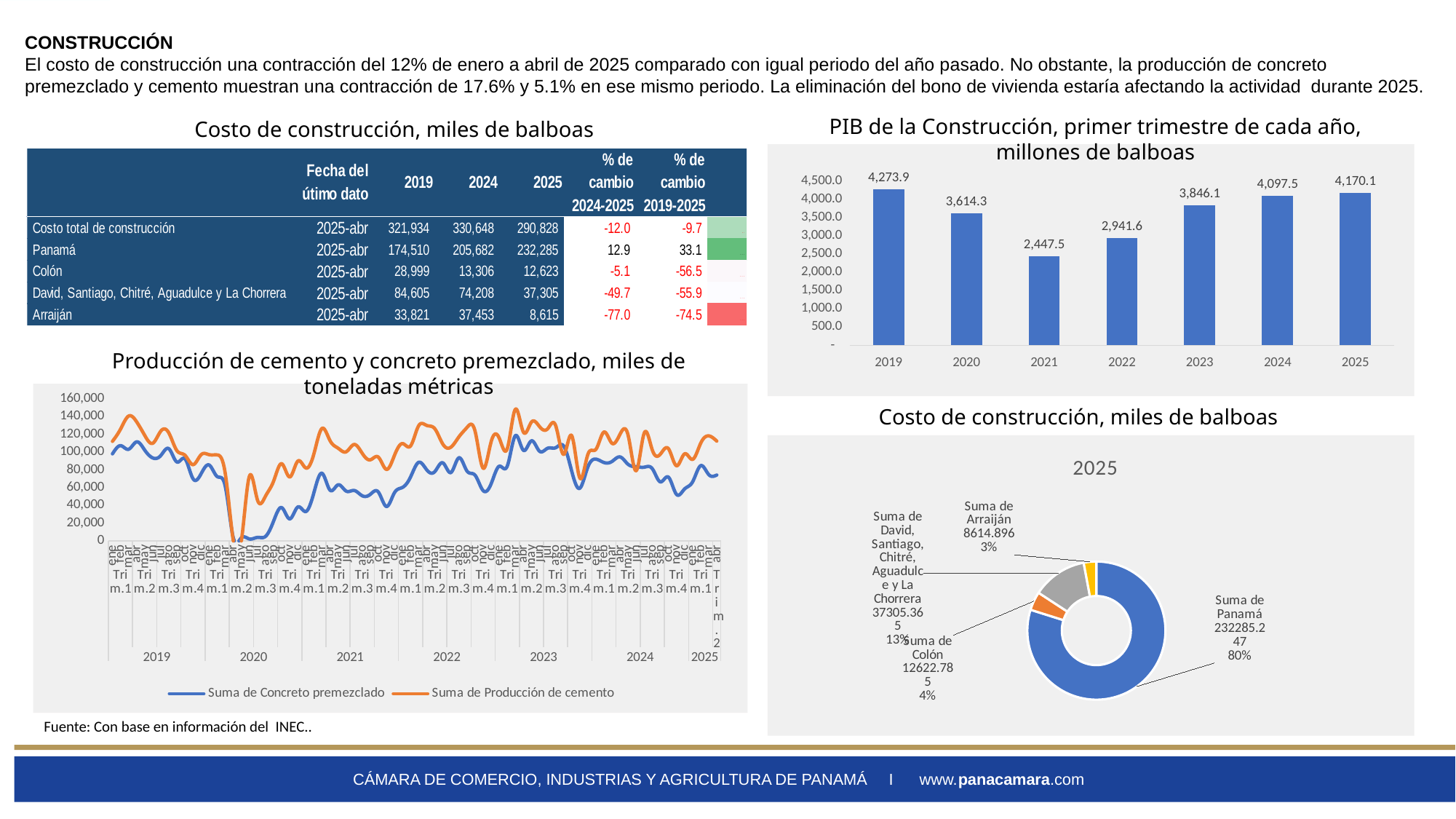
In the chart 'PIB de la Construcción, primer trimestre de cada año, millones de balboas', what is the value for 2025? 4,170.1 In the donut chart 'Costo de construcción, miles de balboas' (bottom right), what is the value shown for 'Suma de Colón'? 12622.785 In the chart 'PIB de la Construcción, primer trimestre de cada año, millones de balboas', which year has the highest value? 2019 In the donut chart 'Costo de construcción, miles de balboas' (bottom right), which slice is the smallest? Suma de Arraiján How many years are shown in the chart 'PIB de la Construcción, primer trimestre de cada año, millones de balboas'? 7 In the chart 'PIB de la Construcción, primer trimestre de cada año, millones de balboas', which is larger, the value for 2023 or the value for 2024? 2024 In the chart 'PIB de la Construcción, primer trimestre de cada año, millones de balboas', what is the difference between the 2019 value and the 2020 value? 659.6 In the donut chart 'Costo de construcción, miles de balboas' (bottom right), what share does 'Suma de Panamá' represent? 80% In the chart 'PIB de la Construcción, primer trimestre de cada año, millones de balboas', what is the value for 2021? 2,447.5 In the chart 'PIB de la Construcción, primer trimestre de cada año, millones de balboas', which year has the lowest value? 2021 What kind of chart is 'PIB de la Construcción, primer trimestre de cada año, millones de balboas'? Bar chart How many series does the legend list in the chart 'Producción de cemento y concreto premezclado, miles de toneladas métricas'? 2